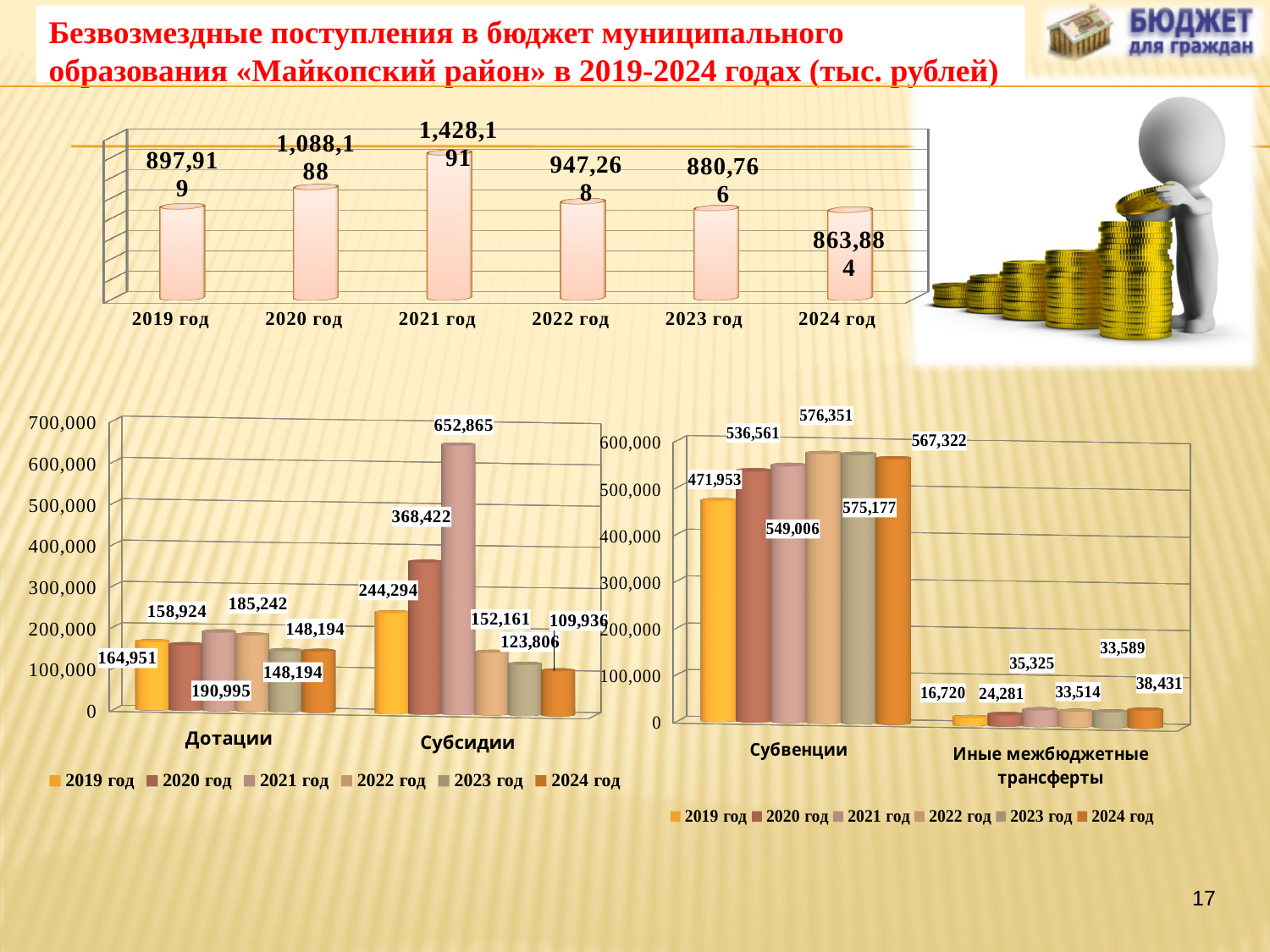
On the bottom-right chart, what is the value for Иные межбюджетные трансферты in 2024 год? 38,431 On the top chart, which year has the highest value? 2021 год On the bottom-right chart, what is the value for Субвенции in 2019 год? 471,953 On the bottom-right chart, is the value for Субвенции in 2019 год greater or less than 500,000? less On the top chart, what is the difference between the values for 2021 год and 2019 год? 530,272 On the bottom-left chart, which year has the highest value for Субсидии? 2021 год On the top chart, how many years are shown? 6 On the bottom-left chart, what is the value for Субсидии in 2021 год? 652,865 On the top chart, what is the value for 2021 год? 1,428,191 On the top chart, which year has the lowest value? 2024 год On the bottom-left chart, how many series does the legend list? 6 On the bottom-left chart, which is larger for Субсидии: 2019 год or 2024 год? 2019 год